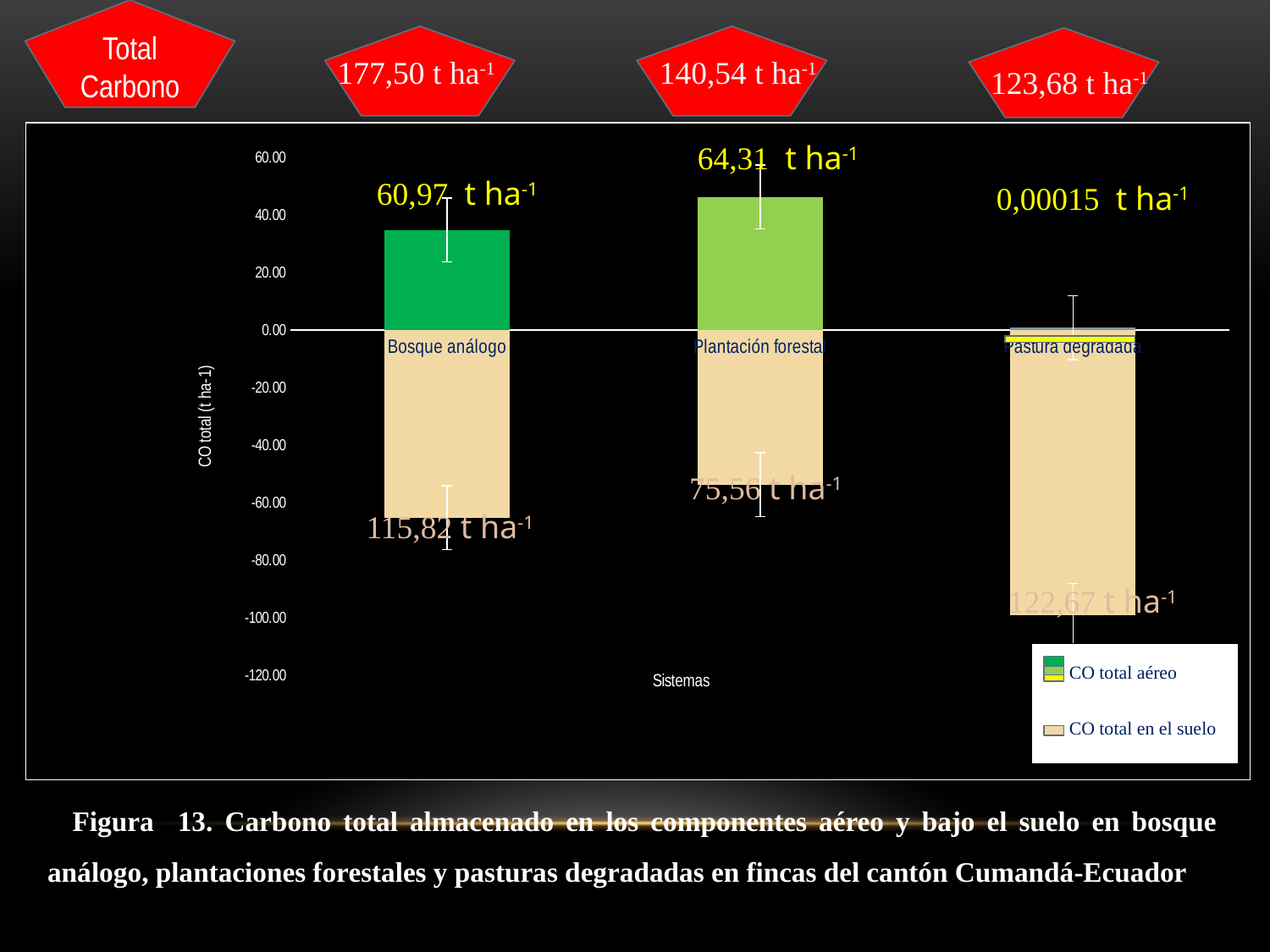
What is the CO total aéreo value labelled for Plantación forestal? 64,31 t ha-1 Which system has the lowest CO total aéreo value? Pastura degradada Which system has the highest CO total aéreo value? Plantación forestal What is the Total Carbono value shown above the chart for Bosque análogo? 177,50 t ha-1 How many series does the chart legend list? 2 What type of chart is shown on the slide? bar chart What is the CO total en el suelo value labelled for Plantación forestal? 75,56 t ha-1 How many systems (categories) are shown on the x axis of the chart? 3 What is the CO total aéreo value labelled for Pastura degradada? 0,00015 t ha-1 What is the CO total aéreo value labelled for Bosque análogo? 60,97 t ha-1 What is the CO total en el suelo value labelled for Bosque análogo? 115,82 t ha-1 Which is larger, the CO total en el suelo value for Bosque análogo or for Plantación forestal? Bosque análogo